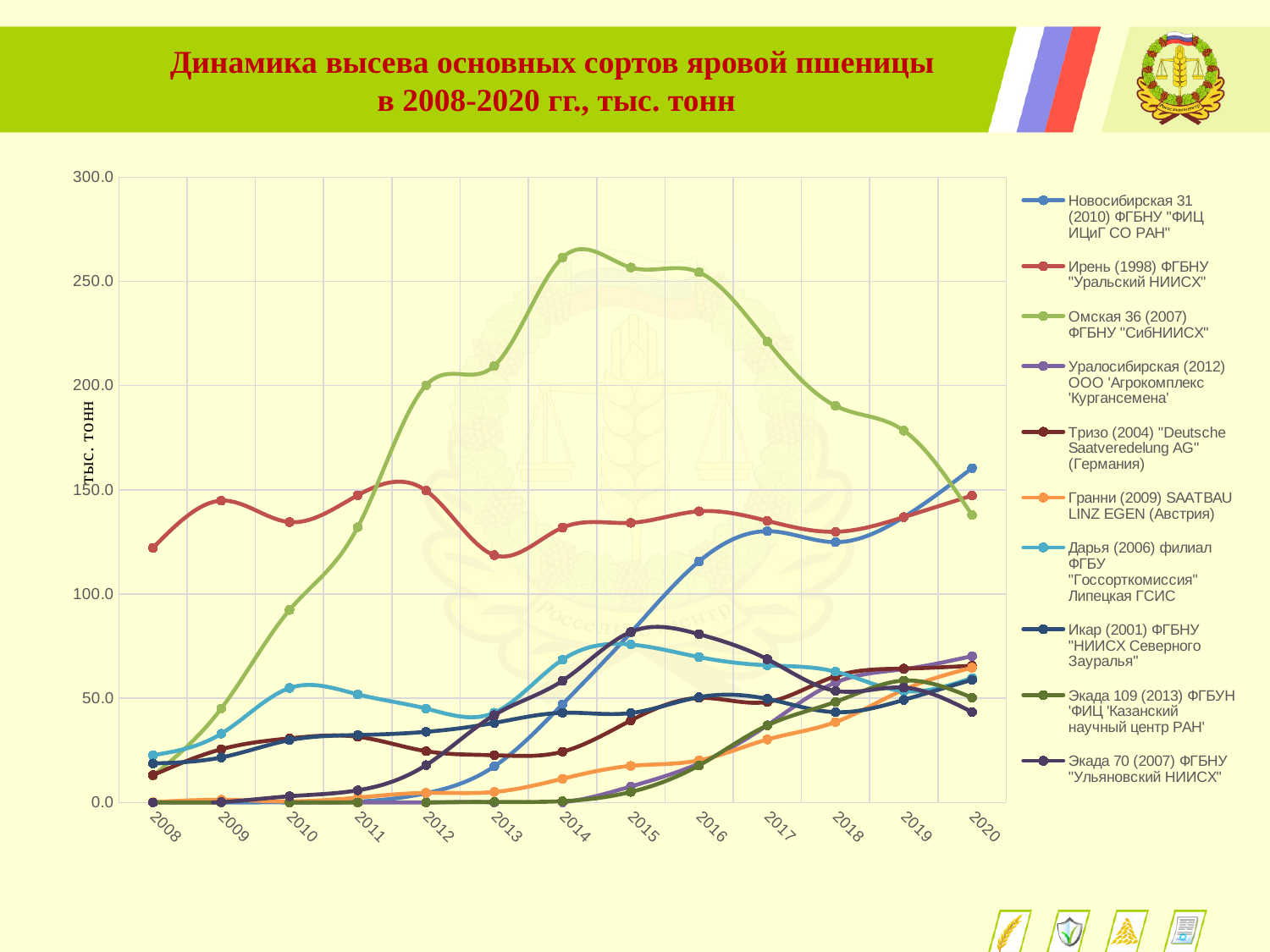
Is the value for Омская 36 in 2020 greater or less than 150? less Which series has the highest value in 2008? Ирень (1998) ФГБНУ "Уральский НИИСХ" Is the value for Омская 36 in 2010 greater or less than 100? less How many years are shown along the x axis? 13 Which series has the highest value in 2014? Омская 36 (2007) ФГБНУ "СибНИИСХ" Is the value for Новосибирская 31 in 2020 greater or less than 150? greater What kind of chart is shown on the slide? line chart Does the value for Омская 36 rise or fall from 2014 to 2020? fall In 2020, which is larger: Новосибирская 31 or Омская 36? Новосибирская 31 What is the label on the y axis? тыс. тонн How many series does the legend list? 10